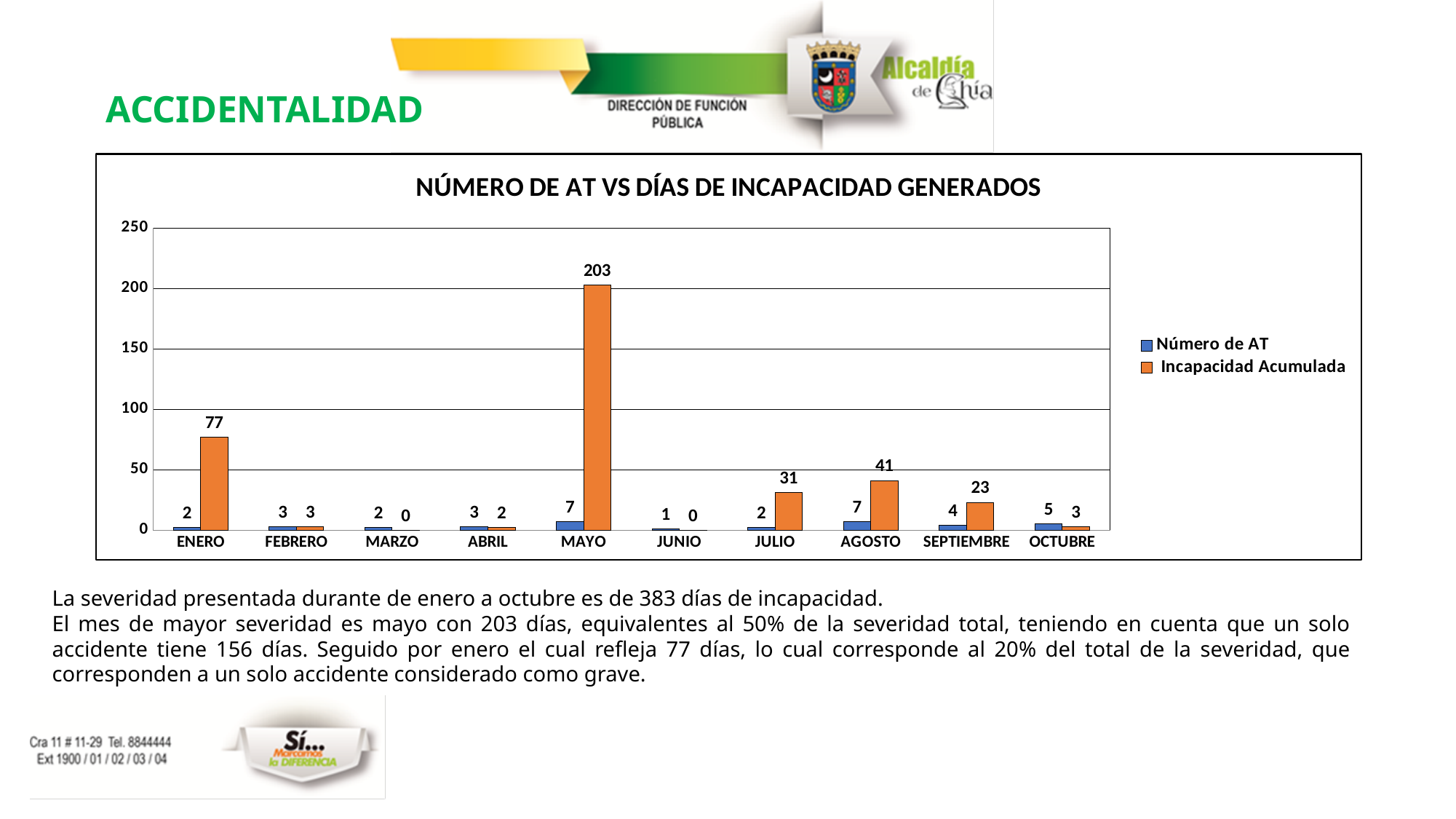
What is the Incapacidad Acumulada value for MAYO? 203 How many series does the legend list? 2 How many months are shown on the x axis? 10 What is the Número de AT value for AGOSTO? 7 Which colour represents Incapacidad Acumulada in the legend? Orange What is the difference between the Incapacidad Acumulada for MAYO and ENERO? 126 What is the Incapacidad Acumulada value for ENERO? 77 What kind of chart is shown? Bar chart Which month has the highest Incapacidad Acumulada? MAYO Which month has the lowest Número de AT? JUNIO Which is larger, the Incapacidad Acumulada for JULIO or for AGOSTO? AGOSTO What is the title of the chart? NÚMERO DE AT VS DÍAS DE INCAPACIDAD GENERADOS